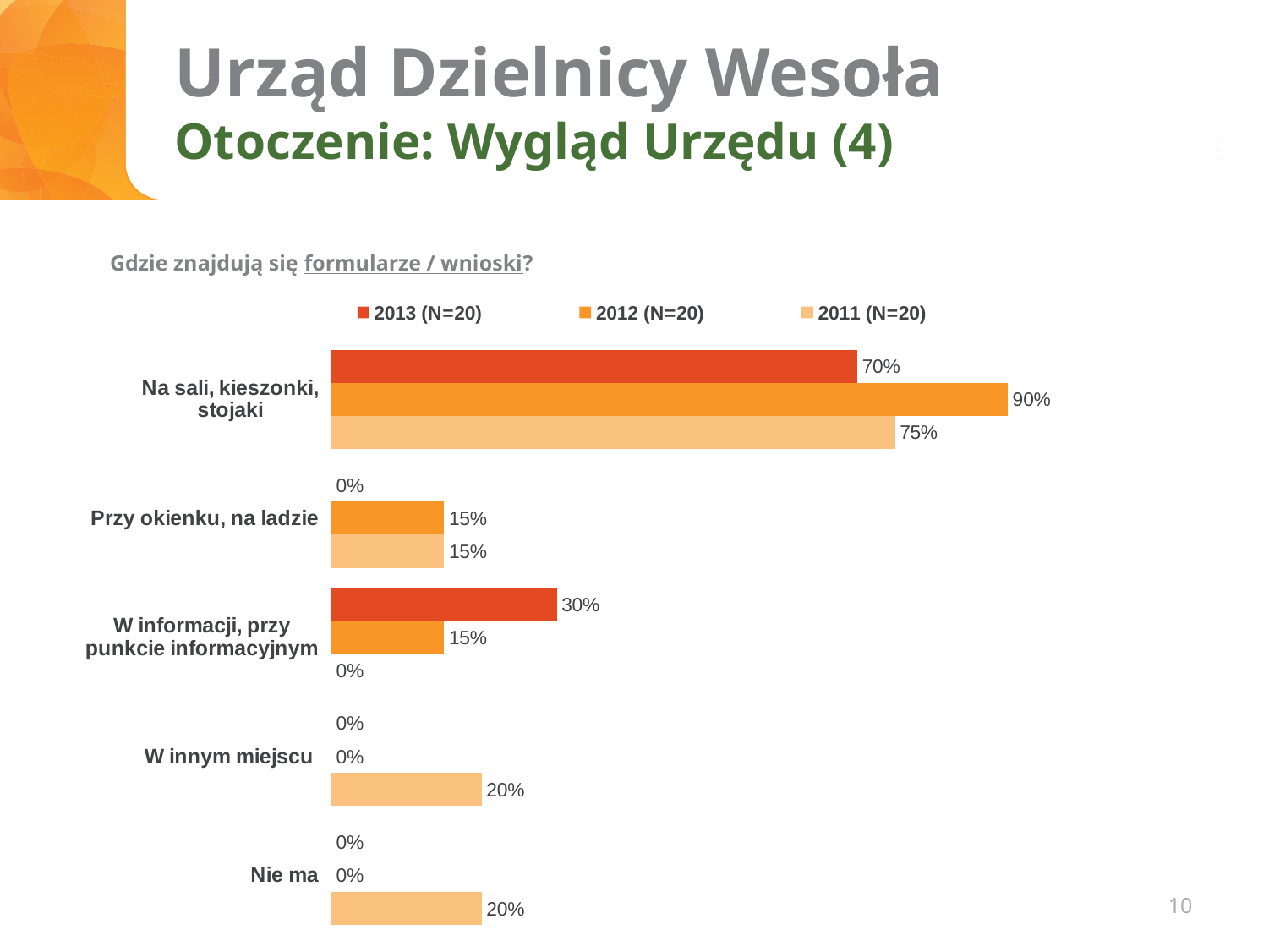
Which category has the highest value for 2013 (N=20)? Na sali, kieszonki, stojaki What is the value for 2013 (N=20) for "W informacji, przy punkcie informacyjnym"? 30% What is the value for 2011 (N=20) for "W innym miejscu"? 20% How many categories are shown on the chart? 5 What is the value for 2012 (N=20) for "Na sali, kieszonki, stojaki"? 90% What kind of chart is shown on the slide? Bar chart Which category has the lowest value for 2011 (N=20)? W informacji, przy punkcie informacyjnym What is the value for 2013 (N=20) for "Przy okienku, na ladzie"? 0% Which is larger for "W informacji, przy punkcie informacyjnym": the 2013 (N=20) value or the 2012 (N=20) value? 2013 (N=20) What question does the chart answer, according to the text above it? Gdzie znajdują się formularze / wnioski? What is the difference between the 2012 (N=20) and 2013 (N=20) values for "Na sali, kieszonki, stojaki"? 20% How many series does the legend list? 3